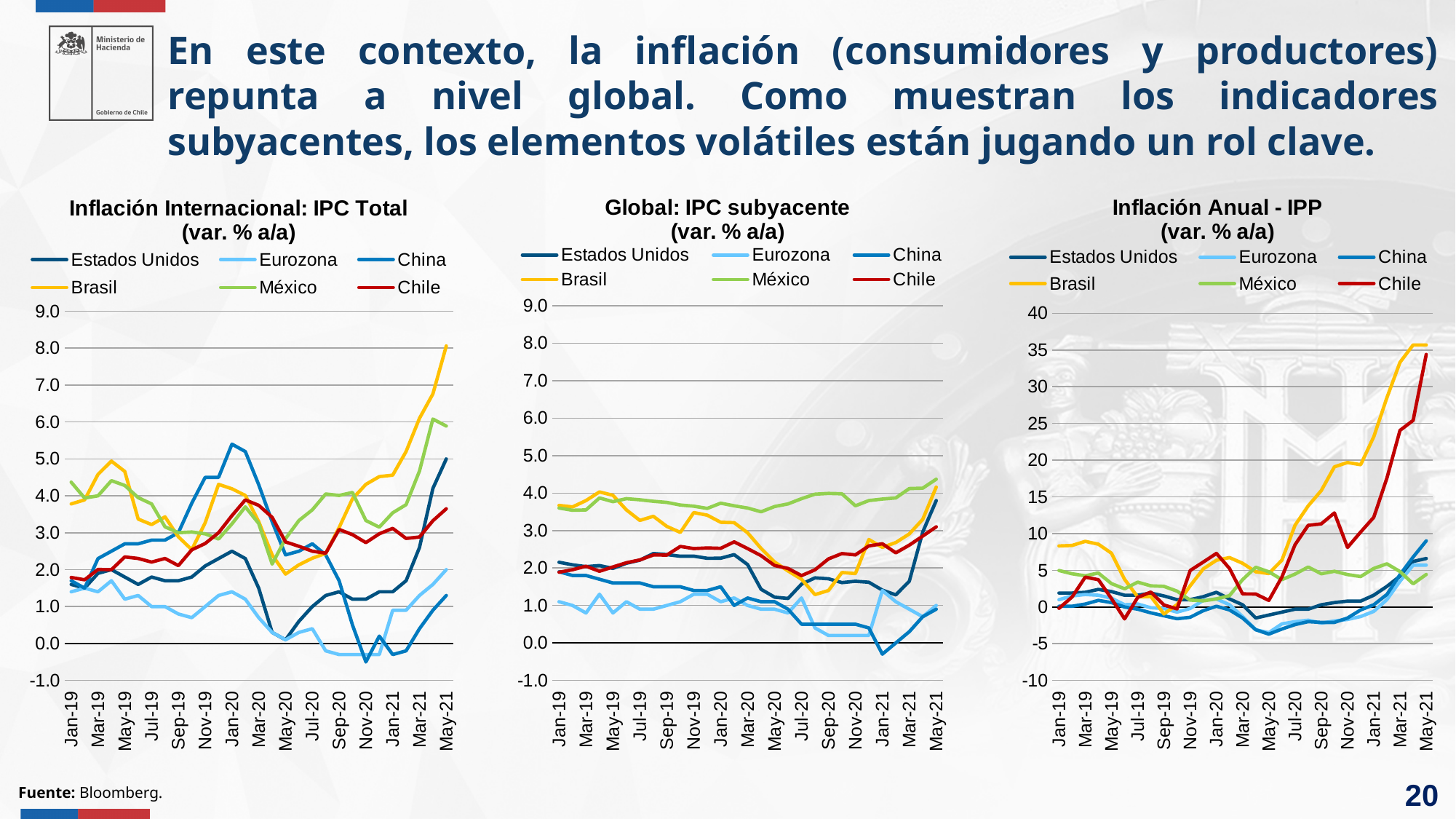
In 'Inflación Internacional: IPC Total (var. % a/a)', is the value for Eurozona at Nov-20 greater or less than 0.0? less In 'Inflación Internacional: IPC Total (var. % a/a)', which series has the highest value at May-21? Brasil How many series does the legend of 'Global: IPC subyacente (var. % a/a)' list? 6 In 'Inflación Anual - IPP (var. % a/a)', is the value for Brasil at May-21 greater or less than 30? greater In 'Global: IPC subyacente (var. % a/a)', which series has the lowest value at Jan-21? China In 'Inflación Internacional: IPC Total (var. % a/a)', is the value for Brasil at May-21 greater or less than 7.0? greater What source is cited for the charts on the slide? Bloomberg In 'Inflación Anual - IPP (var. % a/a)', does the Brasil series rise or fall from May-20 to May-21? rise How many charts are shown on the slide? 3 What kind of chart is 'Inflación Internacional: IPC Total (var. % a/a)'? line chart